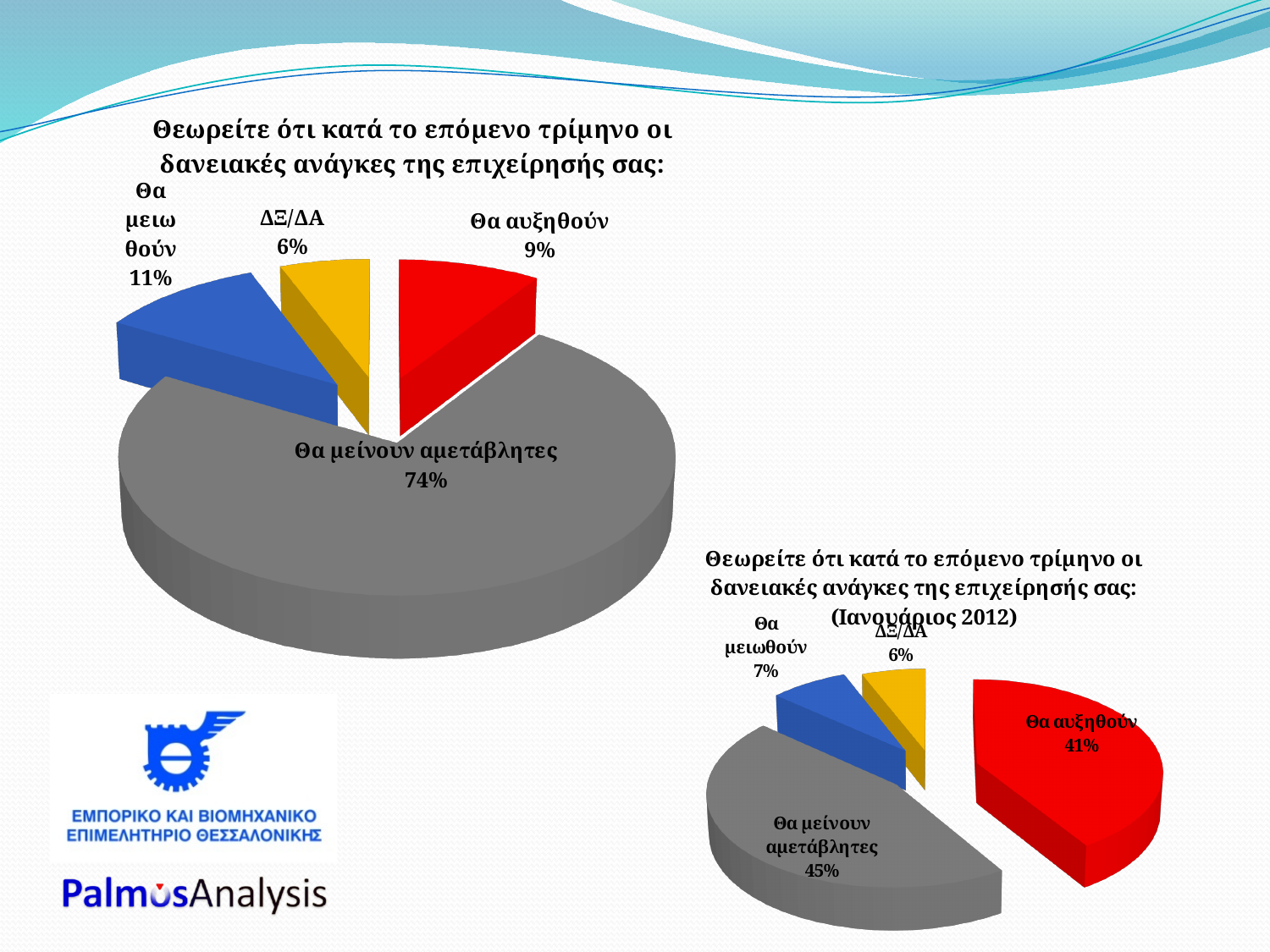
What type of chart is used on this slide? Pie chart In the bottom-right pie chart (Ιανουάριος 2012), what is the difference in percentage points between 'Θα μείνουν αμετάβλητες' and 'Θα αυξηθούν'? 4 percentage points In the bottom-right pie chart (Ιανουάριος 2012), which category has the largest share? Θα μείνουν αμετάβλητες In the top-left pie chart, what percentage is shown for 'Θα αυξηθούν'? 9% In the top-left pie chart, how many slices does the pie have? 4 In the top-left pie chart, what percentage is shown for 'Θα μείνουν αμετάβλητες'? 74% In the top-left pie chart, what colour is the slice for 'Θα μείνουν αμετάβλητες'? Grey Comparing the two charts, is the share for 'Θα αυξηθούν' larger in the top-left chart or in the bottom-right chart (Ιανουάριος 2012)? Bottom-right chart (Ιανουάριος 2012) In the top-left pie chart, what percentage is shown for 'Θα μειωθούν'? 11% In the top-left pie chart, which category has the smallest share? ΔΞ/ΔΑ In the bottom-right pie chart (Ιανουάριος 2012), what percentage is shown for 'Θα μειωθούν'? 7% In the bottom-right pie chart (Ιανουάριος 2012), what percentage is shown for 'Θα αυξηθούν'? 41%